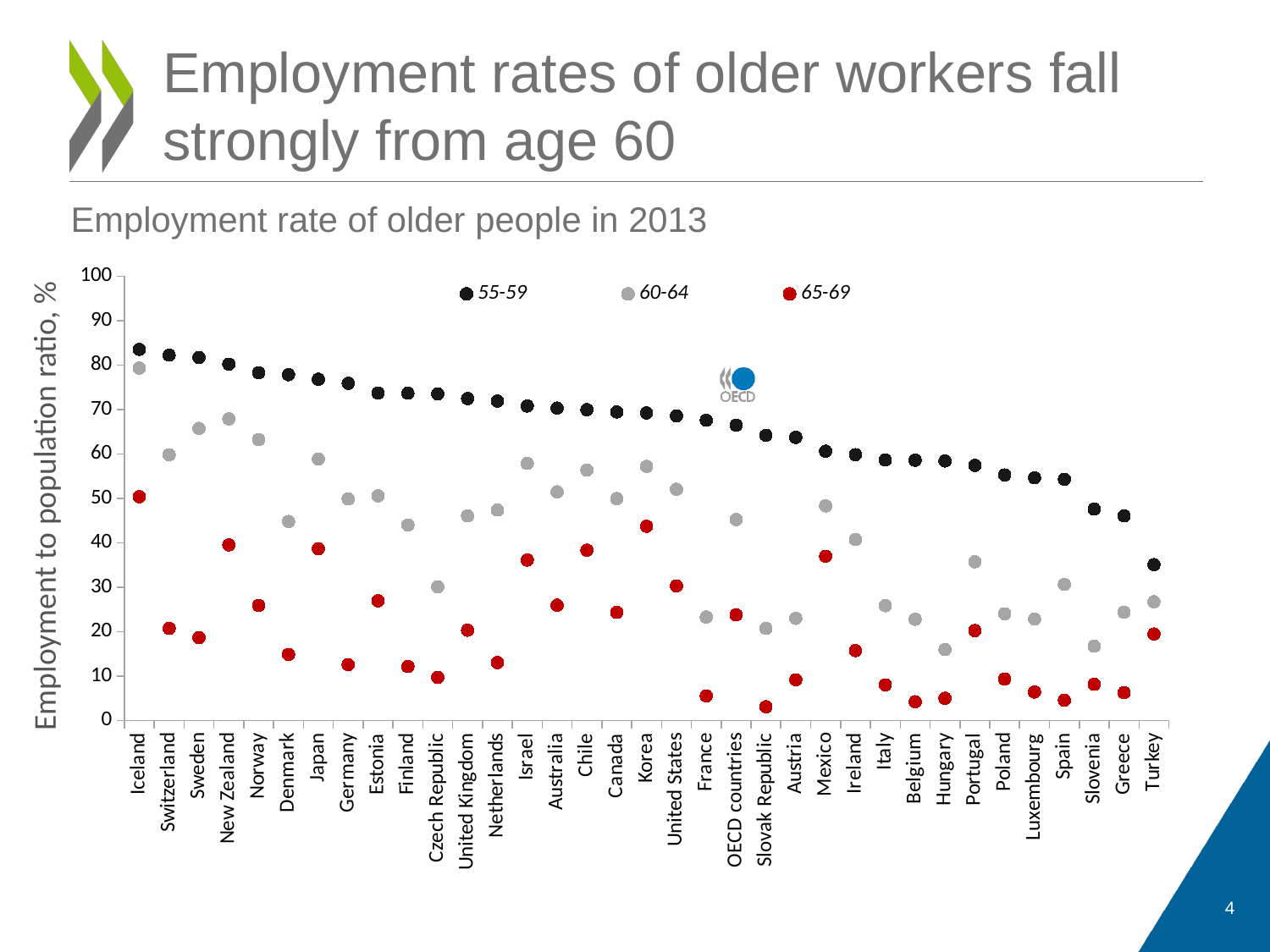
How many series does the legend list? 3 Which category has the highest value for the 60-64 series? Iceland Which category has the lowest value for the 55-59 series? Turkey Do the 55-59 values rise or fall moving from left to right along the x axis? fall What is the label of the y axis? Employment to population ratio, % Which category has the highest value for the 55-59 series? Iceland What kind of chart is shown on the slide? Dot (scatter) chart Is the 55-59 value for Turkey greater or less than 40? less How many countries/categories are plotted along the x axis? 35 Is the 65-69 value for Slovak Republic greater or less than 10? less Is the 65-69 value for Iceland greater or less than 40? greater Which is larger, the 65-69 value for Korea or the 65-69 value for the United States? Korea